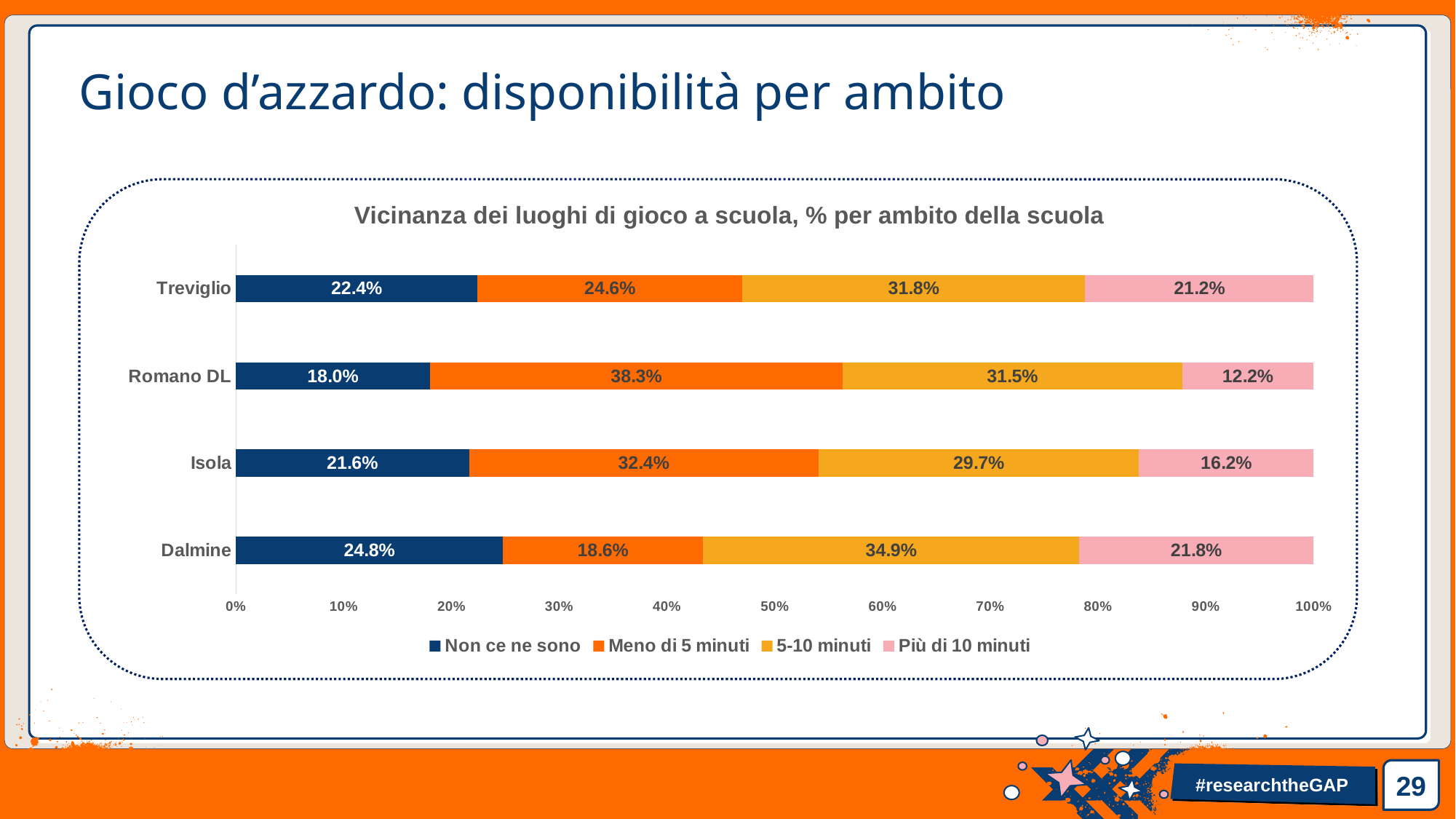
Which category has the highest value for "Meno di 5 minuti"? Romano DL What is the value for "5-10 minuti" for Dalmine? 34.9% Which category has the lowest value for "Più di 10 minuti"? Romano DL How many series does the legend list? 4 Which is larger: the "5-10 minuti" value for Treviglio or for Isola? Treviglio What is the value for "Meno di 5 minuti" for Romano DL? 38.3% What kind of chart is shown on the slide? Stacked bar chart What is the value for "Non ce ne sono" for Treviglio? 22.4% How many categories (school areas) are shown on the y axis? 4 What is the value for "Più di 10 minuti" for Isola? 16.2% What is the title of the chart? Vicinanza dei luoghi di gioco a scuola, % per ambito della scuola What is the difference between the "Non ce ne sono" values for Dalmine and Romano DL? 6.8%